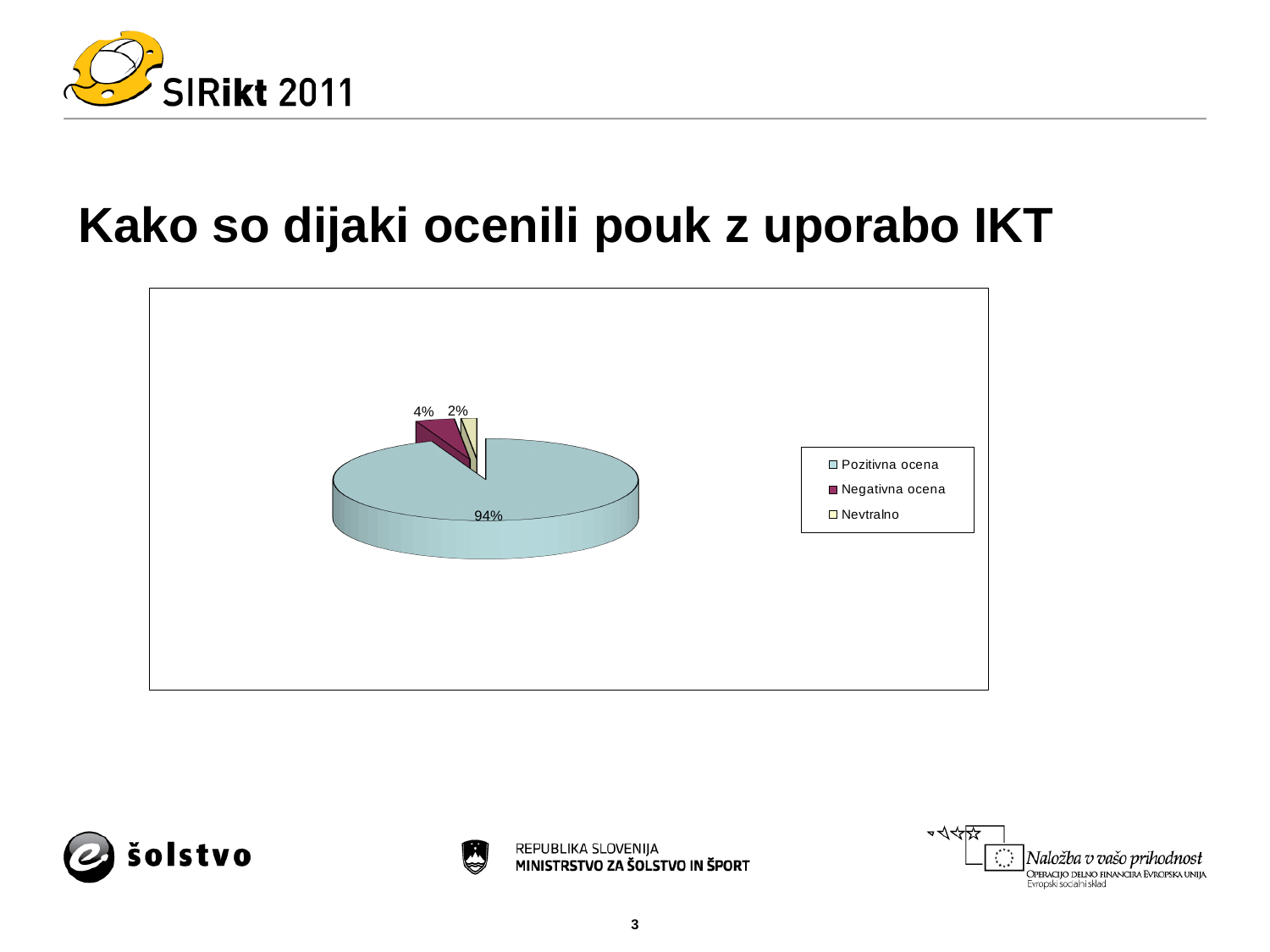
How many slices does the pie chart have? 3 Which is larger, the slice for Negativna ocena or the slice for Nevtralno? Negativna ocena What kind of chart is shown on the slide? pie chart What is the title of the slide above the chart? Kako so dijaki ocenili pouk z uporabo IKT What share of the pie is labelled for Nevtralno? 2% What is the difference in percentage points between Pozitivna ocena and Negativna ocena? 90 What share of the pie is labelled for Pozitivna ocena? 94% Which category has the smallest slice of the pie? Nevtralno What share of the pie is labelled for Negativna ocena? 4% Which category has the largest slice of the pie? Pozitivna ocena What is the difference in percentage points between Negativna ocena and Nevtralno? 2 How many entries does the legend list? 3